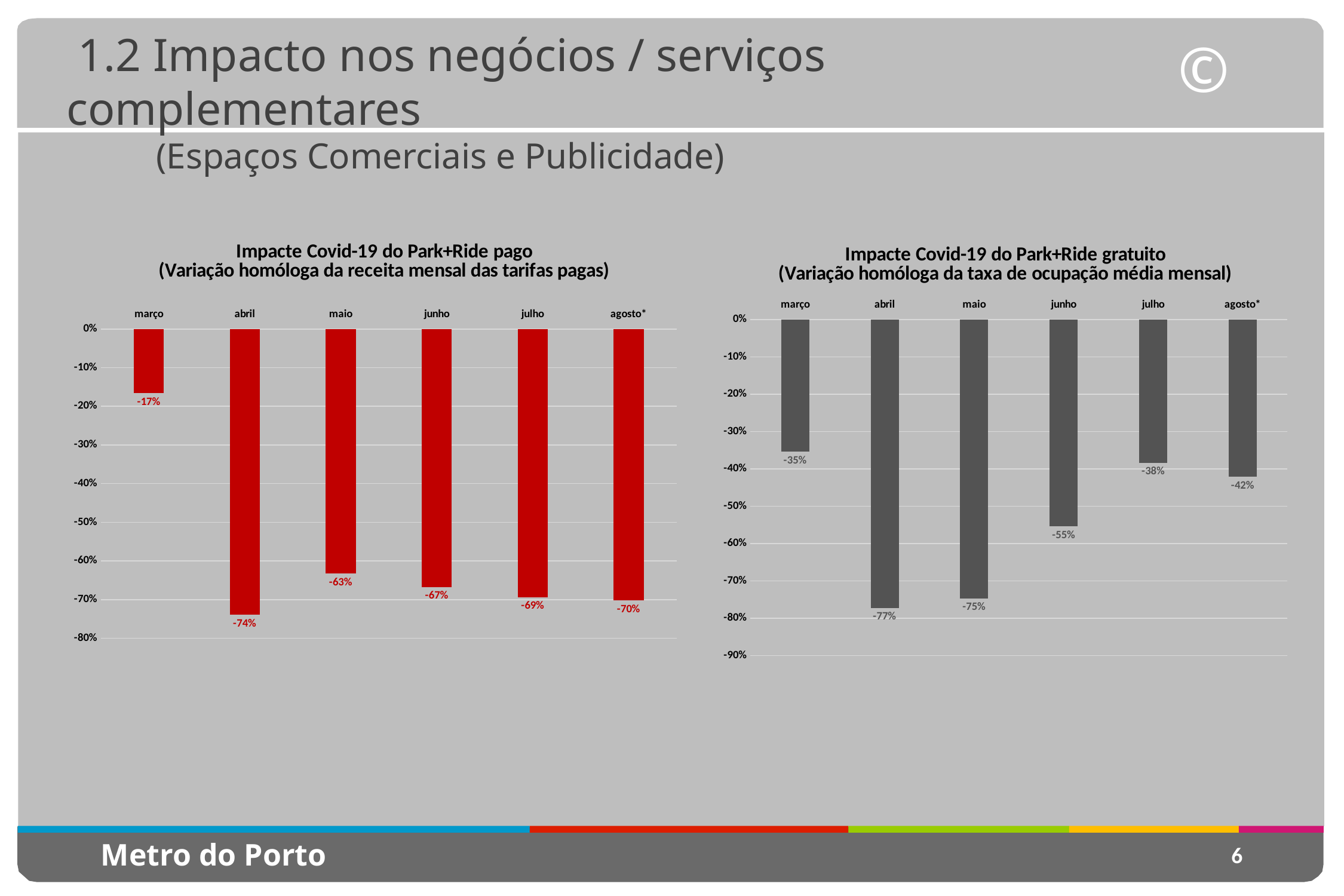
What colour are the bars in the left chart (Impacte Covid-19 do Park+Ride pago)? red In the right chart (Impacte Covid-19 do Park+Ride gratuito), what is the value for agosto*? -42% In the left chart (Impacte Covid-19 do Park+Ride pago), what is the value for abril? -74% In the left chart (Impacte Covid-19 do Park+Ride pago), is the value for junho greater or less than -60%? less In the right chart (Impacte Covid-19 do Park+Ride gratuito), what is the value for junho? -55% What kind of chart is the right chart (Impacte Covid-19 do Park+Ride gratuito)? bar chart How many months are shown in the left chart (Impacte Covid-19 do Park+Ride pago)? 6 In the left chart (Impacte Covid-19 do Park+Ride pago), which month has the lowest value? abril In the right chart (Impacte Covid-19 do Park+Ride gratuito), what is the difference between the values for abril and março? 42 percentage points In the left chart (Impacte Covid-19 do Park+Ride pago), what is the value for março? -17% In the left chart (Impacte Covid-19 do Park+Ride pago), which is larger, the value for maio or the value for julho? maio In the right chart (Impacte Covid-19 do Park+Ride gratuito), which month has the highest value? março